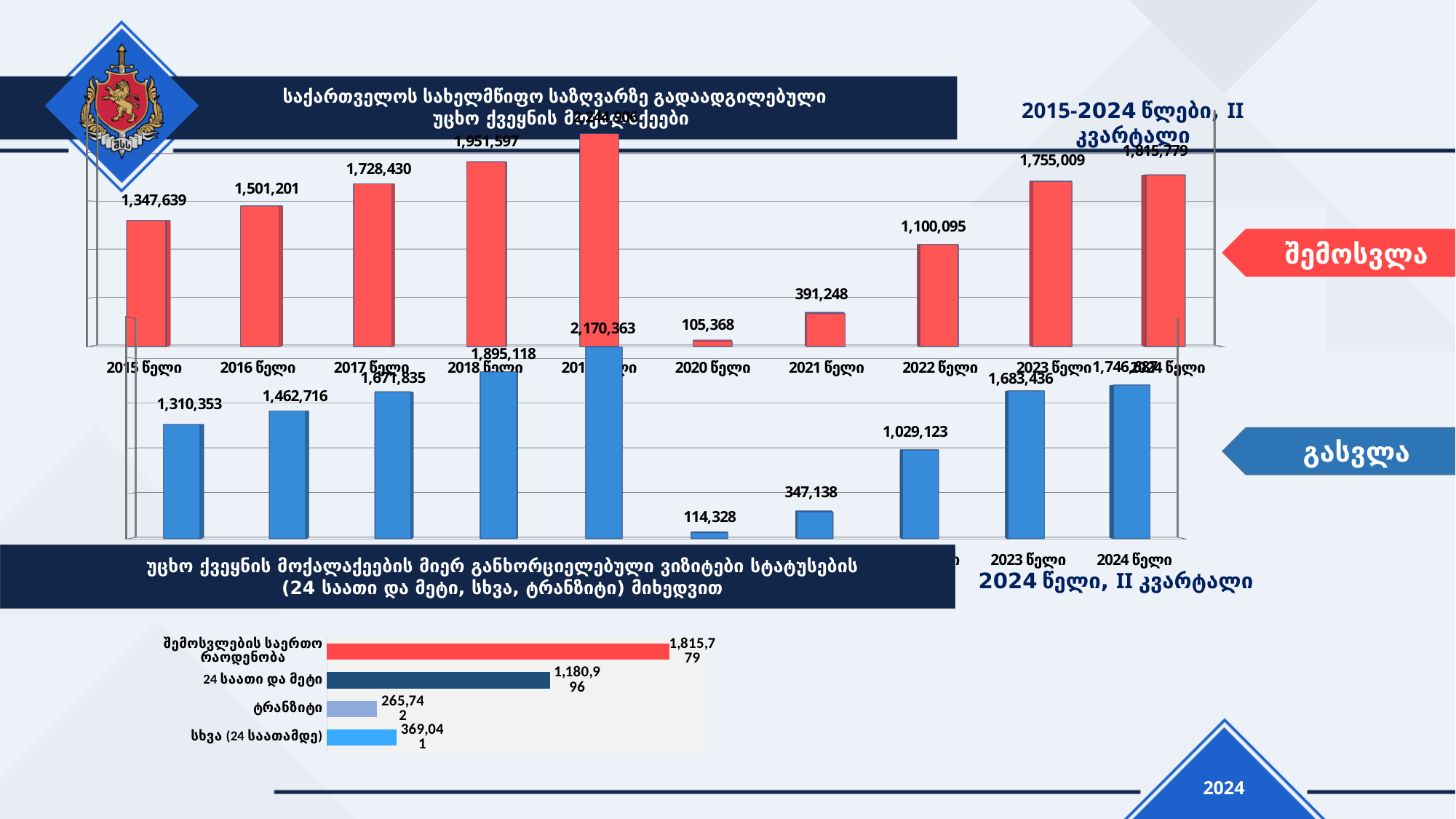
How many years are shown in the red bar chart (შემოსვლა)? 10 In the red bar chart (შემოსვლა), what is the value for 2018 წელი? 1,951,597 What kind of chart is the bottom chart on the slide? bar chart In the bottom horizontal bar chart, what is the value for ტრანზიტი? 265,742 In the blue bar chart (გასვლა), which is larger: the value for 2023 წელი or 2022 წელი? 2023 წელი In the red bar chart (შემოსვლა), what is the value for 2022 წელი? 1,100,095 In the blue bar chart (გასვლა), what is the value for 2015 წელი? 1,310,353 In the bottom horizontal bar chart, which category has the smallest value? ტრანზიტი In the blue bar chart (გასვლა), which year has the lowest value? 2020 წელი In the red bar chart (შემოსვლა), which year has the lowest value? 2020 წელი In the red bar chart (შემოსვლა), what is the difference between the values for 2024 წელი and 2023 წელი? 60,770 In the bottom horizontal bar chart, what is the difference between 24 საათი და მეტი and სხვა (24 საათამდე)? 811,955